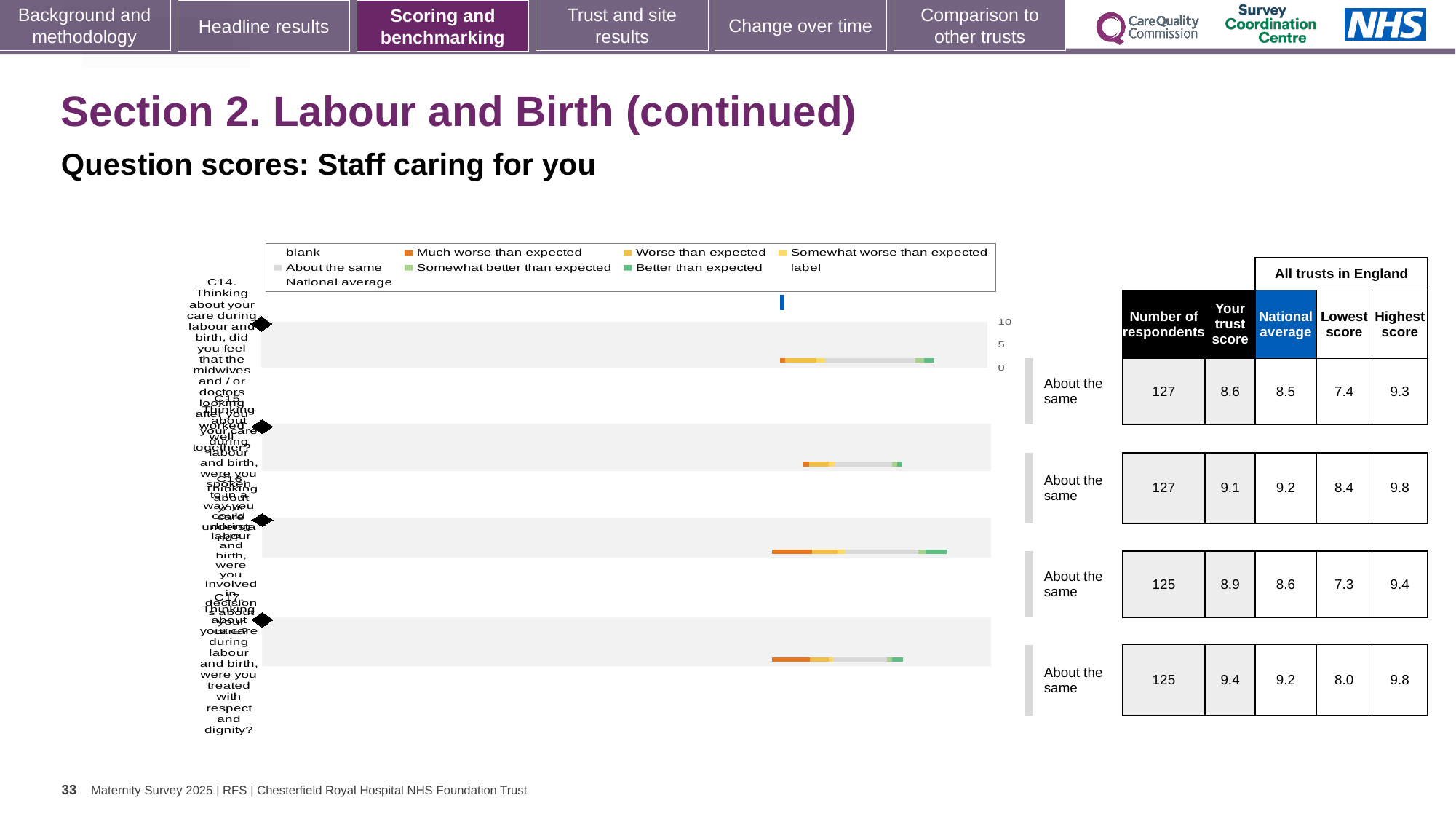
What colour does the legend use for 'Better than expected'? green In the table beside the chart, what is the national average for the second row? 9.2 In the table beside the chart, what is the highest score for the third row? 9.4 In the table beside the chart, what is the number of respondents for the first row (C14)? 127 In the table beside the chart, what is the difference between 'Your trust score' and the national average for the fourth row? 0.2 How many question rows (bars) are plotted in the chart? 4 What benchmark category is shown next to every bar in the chart? About the same What kind of chart is shown on the slide? bar chart In the table beside the chart, what is 'Your trust score' for the first row (C14)? 8.6 What colour does the legend use for 'Much worse than expected'? orange In the table beside the chart, what is the lowest score for the fourth row? 8.0 In the table beside the chart, which row has the highest 'Your trust score'? the fourth row (9.4)